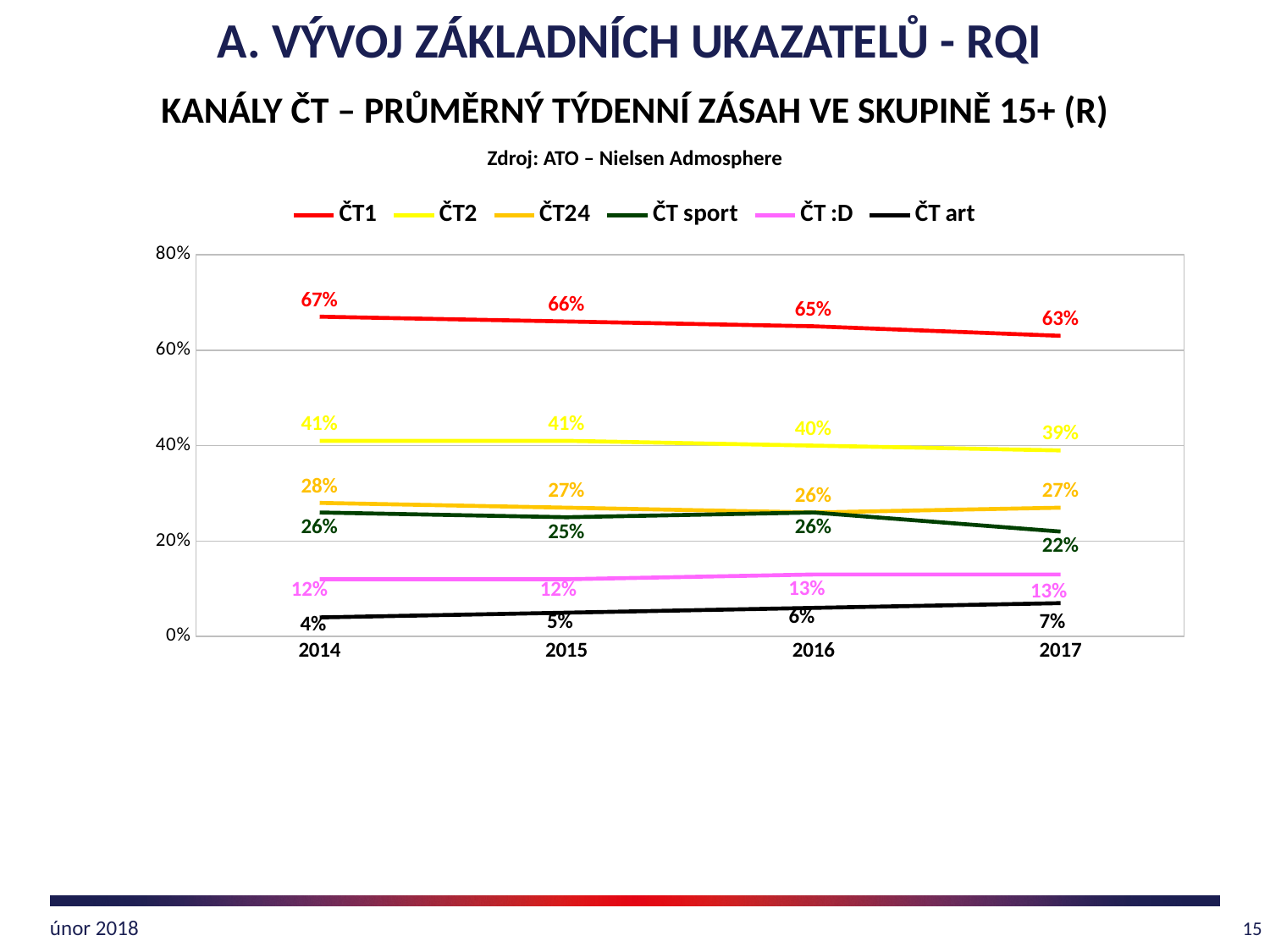
How many series does the legend list? 6 What is the value for ČT art in 2016? 6% What is the value for ČT :D in 2017? 13% What is the value for ČT sport in 2017? 22% Which series has the lowest value in 2014? ČT art How many years are shown on the x axis? 4 Which is larger, the ČT2 value in 2015 or the ČT24 value in 2015? ČT2 Which series has the highest value in 2017? ČT1 What kind of chart is shown on the slide? line chart Does the ČT1 line rise or fall from 2014 to 2017? fall What is the difference between the ČT1 value in 2014 and in 2017? 4% What is the value for ČT1 in 2014? 67%